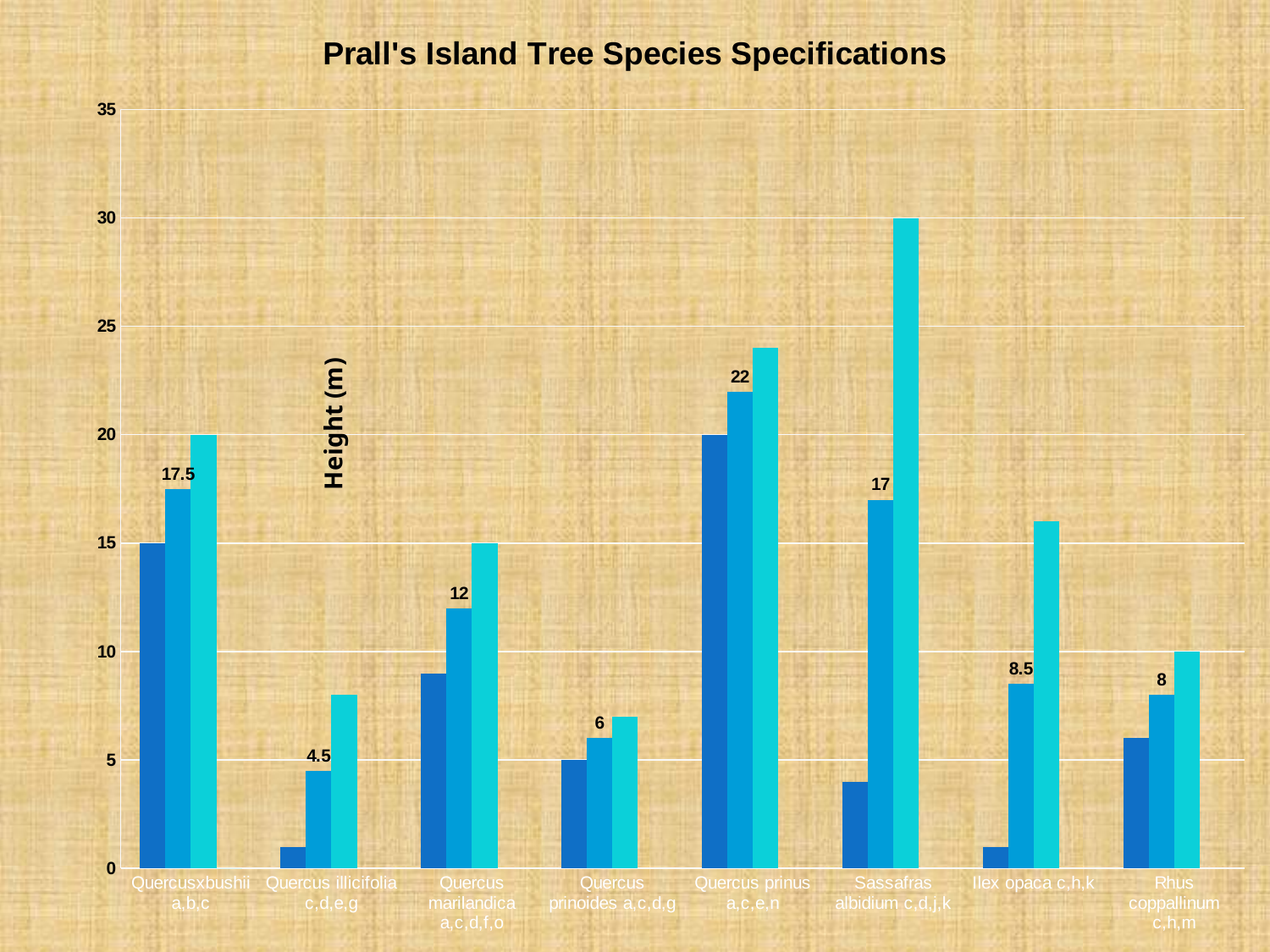
What is the labelled value of the medium blue bar for Quercus illicifolia c,d,e,g? 4.5 Which species has the lowest labelled value among the medium blue bars? Quercus illicifolia c,d,e,g What is the label on the vertical axis of the chart? Height (m) How many tree species categories are shown on the x axis? 8 What is the difference between the labelled values for Quercus prinus a,c,e,n and Quercusxbushii a,b,c? 4.5 What is the labelled value of the medium blue bar for Ilex opaca c,h,k? 8.5 Which species has the highest labelled value among the medium blue bars? Quercus prinus a,c,e,n What type of chart is shown on the slide? bar chart Which has the larger labelled value: Sassafras albidium c,d,j,k or Quercus marilandica a,c,d,f,o? Sassafras albidium c,d,j,k Is the value of the light cyan bar for Sassafras albidium c,d,j,k greater or less than 25? greater What is the labelled value of the medium blue bar for Quercus prinus a,c,e,n? 22 Is the value of the dark blue bar for Ilex opaca c,h,k greater or less than 5? less